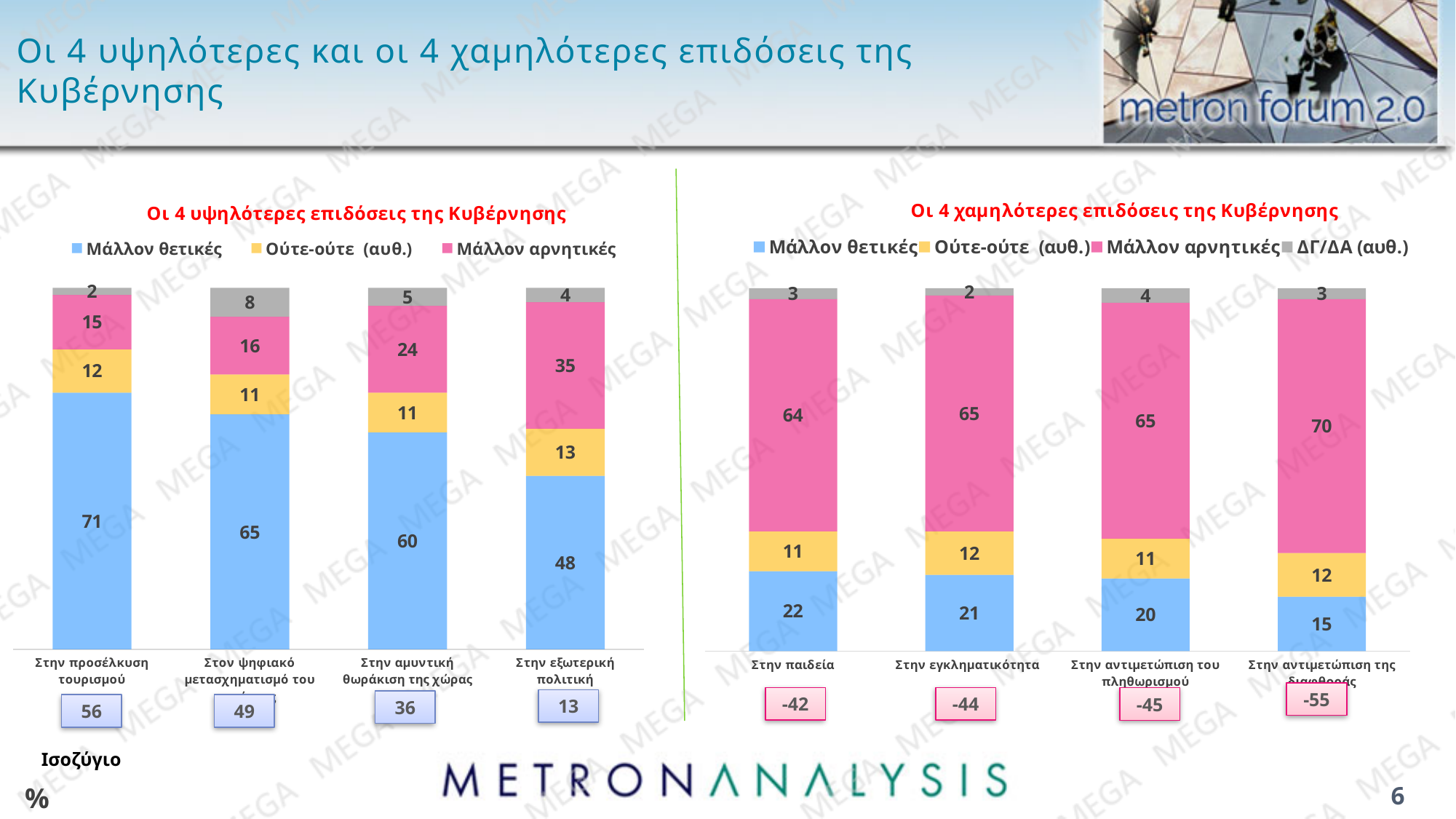
In the right chart (Οι 4 χαμηλότερες επιδόσεις της Κυβέρνησης), which is larger: the Μάλλον θετικές value for Στην παιδεία or for Στην αντιμετώπιση του πληθωρισμού? Στην παιδεία In the left chart (Οι 4 υψηλότερες επιδόσεις της Κυβέρνησης), which category has the highest Μάλλον θετικές value? Στην προσέλκυση τουρισμού How many series does the legend of the right chart (Οι 4 χαμηλότερες επιδόσεις της Κυβέρνησης) list? 4 In the right chart (Οι 4 χαμηλότερες επιδόσεις της Κυβέρνησης), what is the value of Μάλλον αρνητικές for Στην αντιμετώπιση της διαφθοράς? 70 In the left chart (Οι 4 υψηλότερες επιδόσεις της Κυβέρνησης), what is the value of Μάλλον θετικές for Στην προσέλκυση τουρισμού? 71 In the right chart (Οι 4 χαμηλότερες επιδόσεις της Κυβέρνησης), which category has the lowest Μάλλον θετικές value? Στην αντιμετώπιση της διαφθοράς How many categories are shown in the left chart (Οι 4 υψηλότερες επιδόσεις της Κυβέρνησης)? 4 What is the Ισοζύγιο value shown below Στην εξωτερική πολιτική in the left chart? 13 In the left chart (Οι 4 υψηλότερες επιδόσεις της Κυβέρνησης), do the Μάλλον θετικές values rise or fall from left to right across the categories? Fall In the left chart (Οι 4 υψηλότερες επιδόσεις της Κυβέρνησης), what is the difference between the Μάλλον αρνητικές values for Στην εξωτερική πολιτική and Στην προσέλκυση τουρισμού? 20 What kind of chart is the left chart (Οι 4 υψηλότερες επιδόσεις της Κυβέρνησης)? Stacked bar chart In the right chart (Οι 4 χαμηλότερες επιδόσεις της Κυβέρνησης), what is the total of the stacked bar for Στην παιδεία? 100